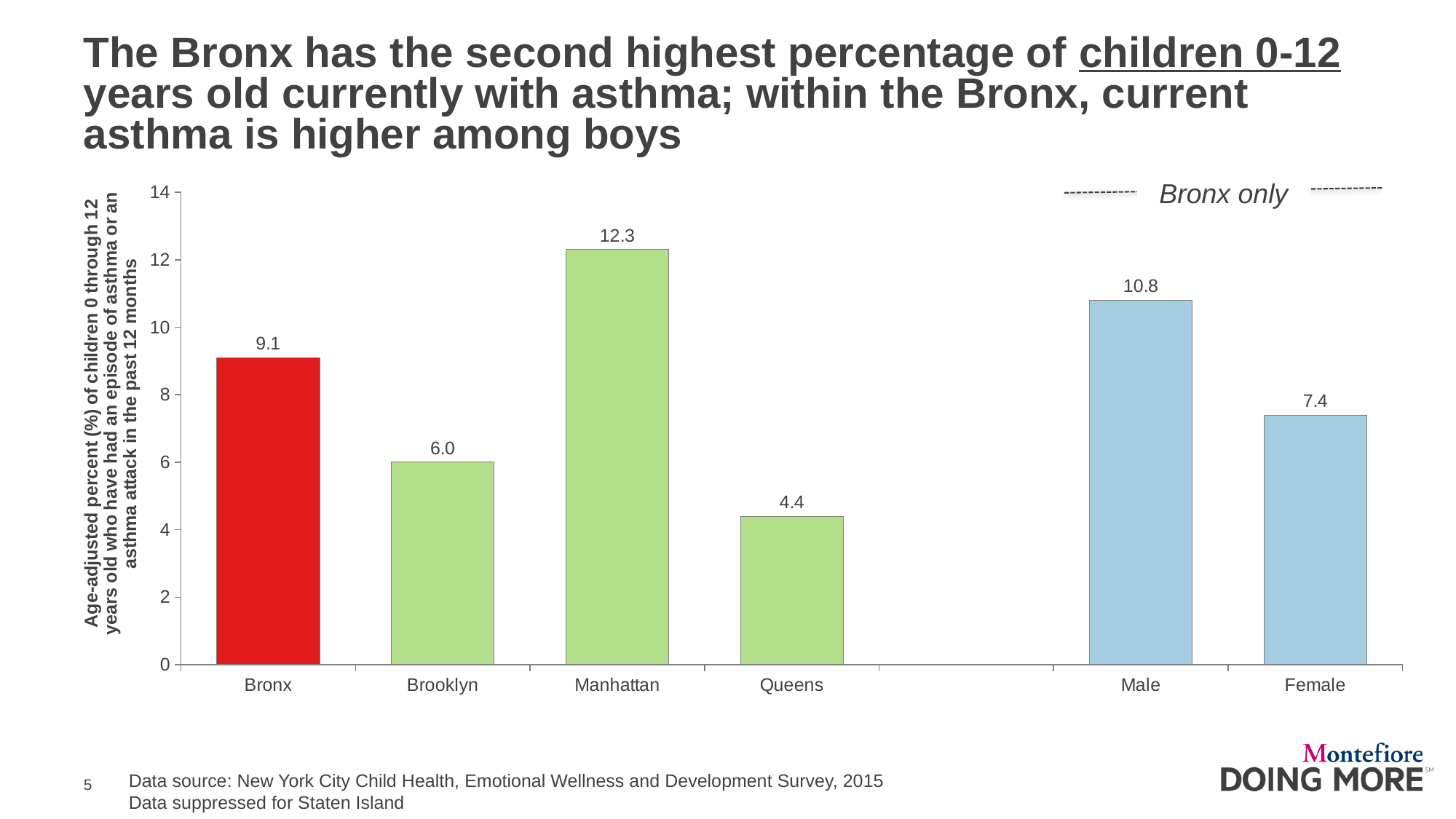
What is the difference between the Male and Female values? 3.4 What is the value for Female in the Bronx only section? 7.4 What is the value for Manhattan? 12.3 Which borough has the highest value? Manhattan Which borough has the lowest value? Queens What is the value for Bronx? 9.1 What kind of chart is shown? bar chart What colour is the Bronx bar? red What is the difference between the Manhattan and Bronx values? 3.2 What is the value for Male in the Bronx only section? 10.8 Which is larger, the value for Brooklyn or the value for Queens? Brooklyn How many bars are plotted on the chart? 6